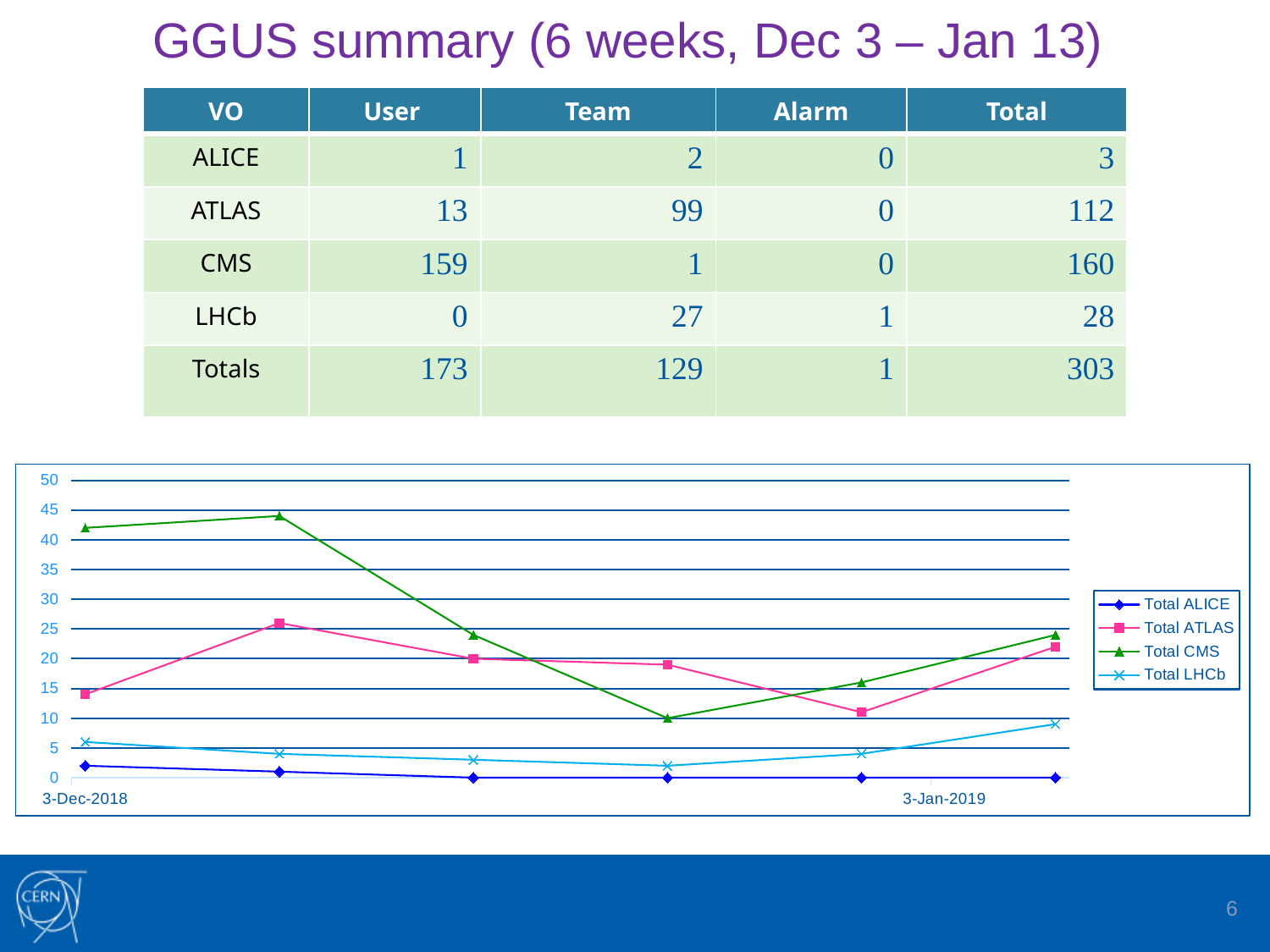
What kind of chart is shown on the slide? line chart Does the Total CMS line rise or fall between its second and fourth points? fall Is the value for Total CMS at the last point of the chart greater or less than 20? greater At 3-Dec-2018, which is larger: Total CMS or Total ATLAS? Total CMS At the last point of the chart, which is larger: Total ATLAS or Total LHCb? Total ATLAS What are the four entries in the chart's legend? Total ALICE, Total ATLAS, Total CMS, Total LHCb How many series does the chart's legend list? 4 Which series has the highest value at 3-Dec-2018? Total CMS Is the value for Total ATLAS at 3-Dec-2018 greater or less than 10? greater How many data points does each series in the chart have? 6 Is the value for Total CMS at 3-Dec-2018 greater or less than 40? greater Which series has the lowest value at the last point of the chart? Total ALICE